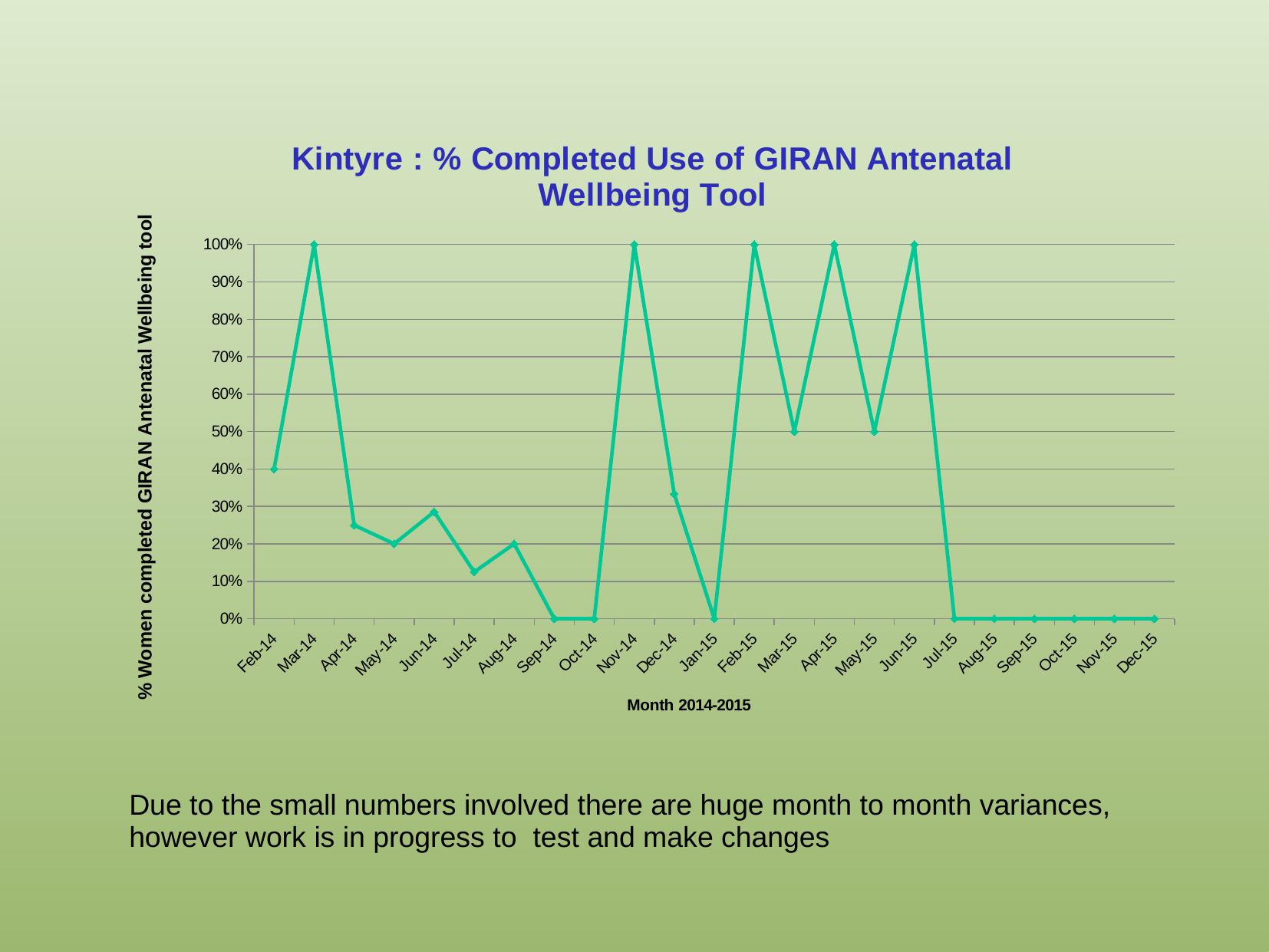
What is the title of the chart? Kintyre : % Completed Use of GIRAN Antenatal Wellbeing Tool What is the value for Mar-15? 50% What is the label of the x axis? Month 2014-2015 Do the values rise or fall from Jun-15 to Jul-15? fall Which is larger, the value for Feb-14 or the value for May-14? Feb-14 What is the value for Feb-14? 40% What is the value for Sep-14? 0% What is the value for Mar-14? 100% Is the value for Apr-14 greater or less than 30%? less How many months are plotted on the x axis? 23 What kind of chart is shown on the slide? line chart Is the value for Dec-14 greater or less than 50%? less